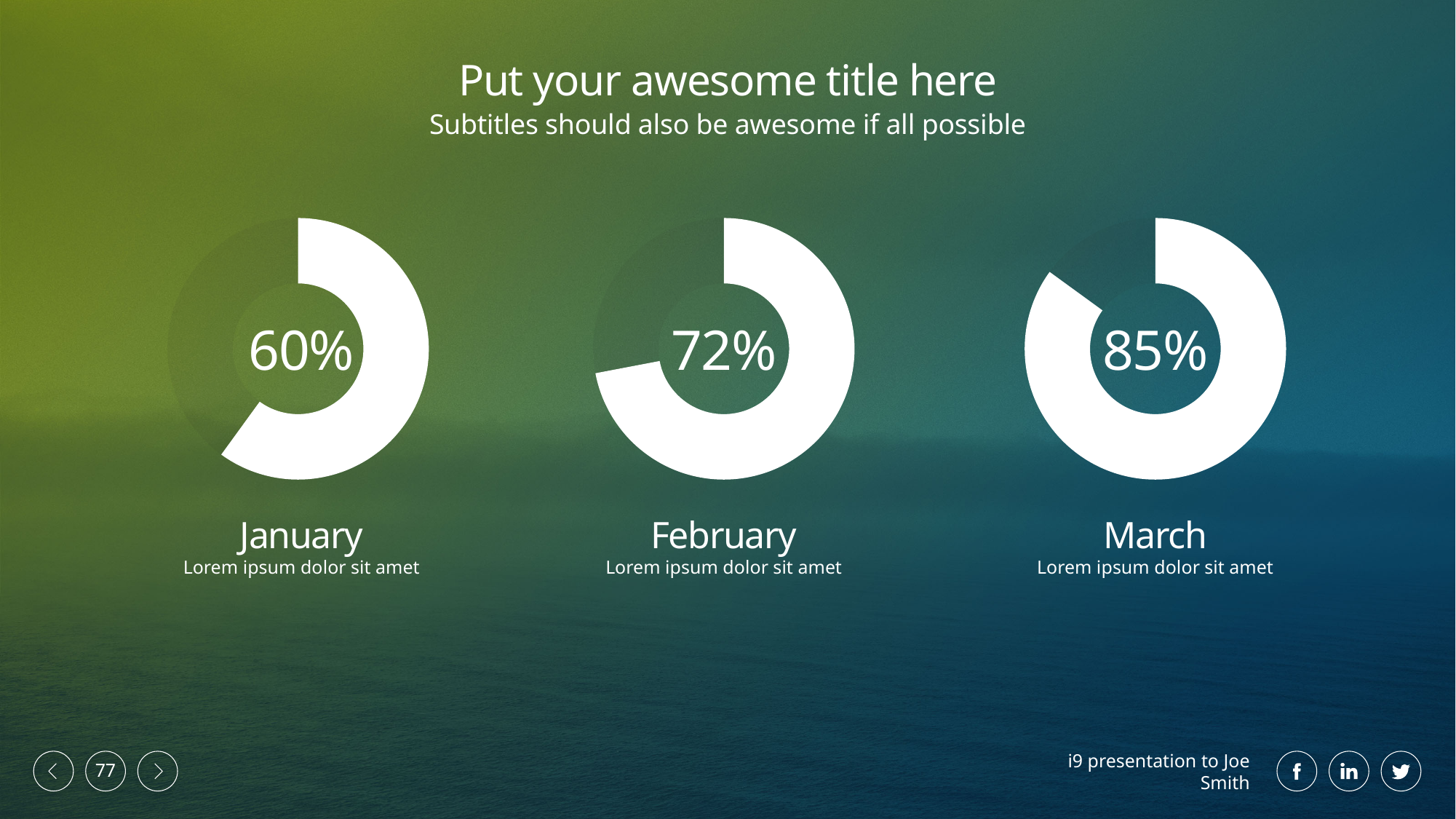
Which month's donut chart shows the lowest percentage? January Do the percentages rise or fall from January to March? Rise What kind of chart is used to show each month's percentage? Donut chart What is the difference between the February and January percentages? 12% How many donut charts are on the slide? 3 What percentage is shown in the January donut chart? 60% What percentage is shown in the March donut chart? 85% What is the difference between the March and January percentages? 25% Which month's donut chart shows the highest percentage? March What colour is the filled portion of each donut chart? White What percentage is shown in the February donut chart? 72% Which is larger, the February percentage or the March percentage? March